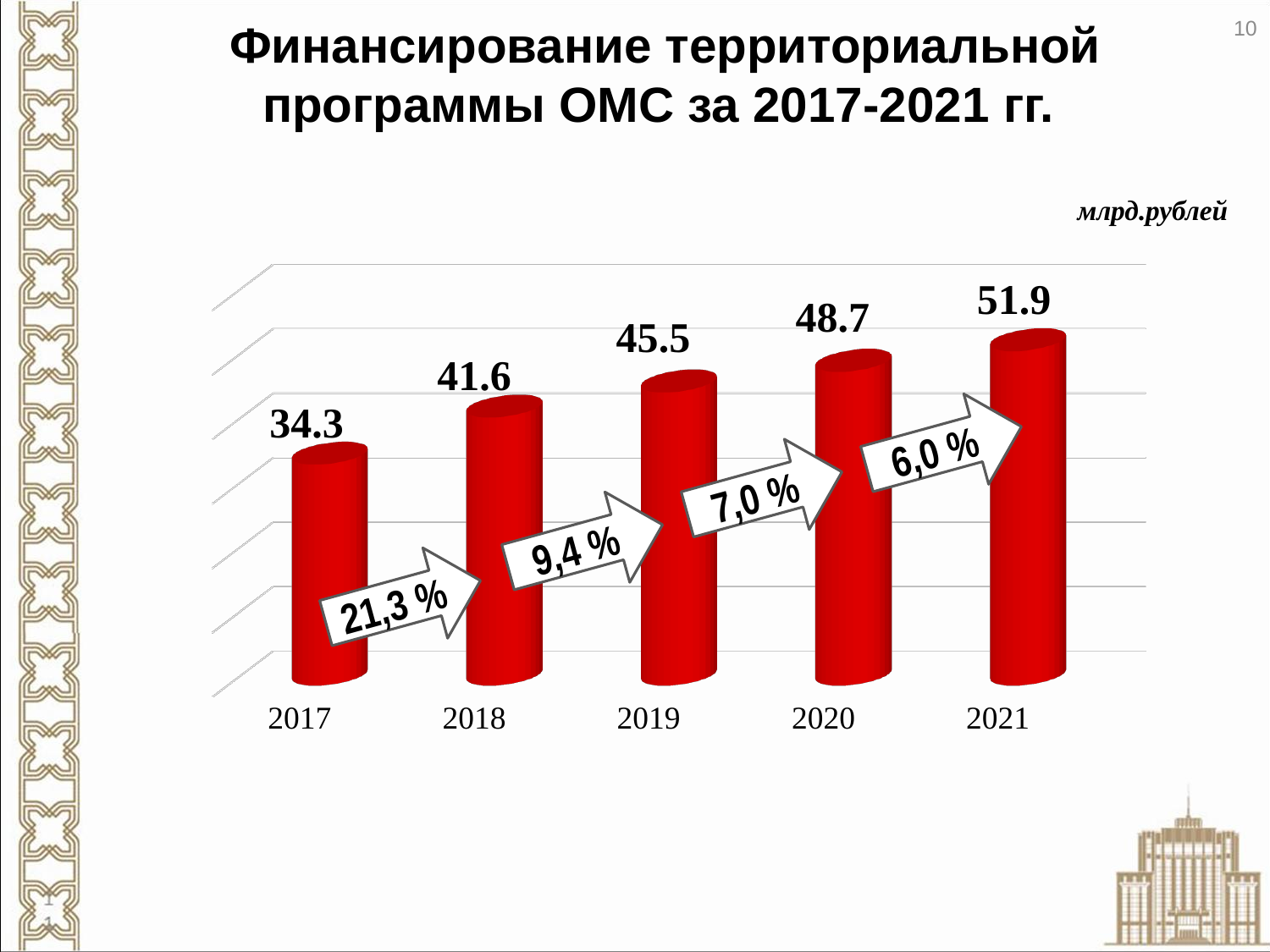
What percentage growth is shown on the arrow between 2017 and 2018? 21,3 % Do the values rise or fall from 2017 to 2021? rise What kind of chart is shown on the slide? bar chart What is the difference between the values for 2020 and 2019? 3.2 What is the value for 2021? 51.9 What is the value for 2019? 45.5 Which is larger, the value for 2018 or the value for 2020? 2020 Which year has the lowest value? 2017 What is the value for 2017? 34.3 Which year has the highest value? 2021 How many years are shown on the chart? 5 What is the difference between the values for 2021 and 2017? 17.6